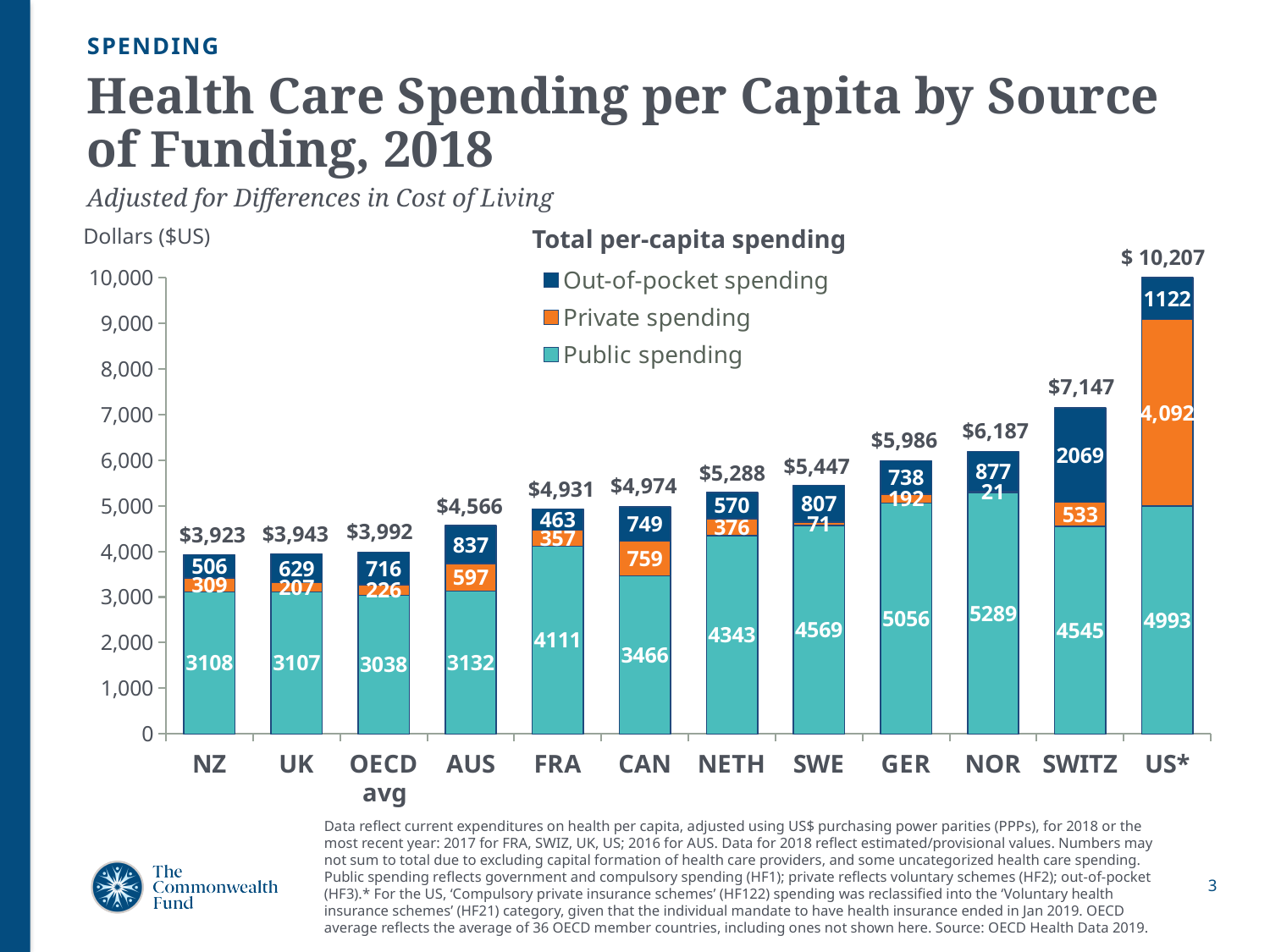
Which country has the highest total per-capita spending? US* Which colour represents public spending in the chart? Teal What is the private spending value for Canada (CAN)? 759 How many countries or groups are shown on the x axis? 12 What is the difference between the total per-capita spending of the US* and Switzerland (SWITZ)? $3,060 What kind of chart is shown on the slide? Stacked bar chart What is the public spending value for Norway (NOR)? 5289 Which has a larger private spending value, the US* or Canada (CAN)? US* How many spending categories does the legend list? 3 What is the total per-capita health care spending for the US* shown above its bar? $ 10,207 Which country has the lowest total per-capita spending? NZ What is the out-of-pocket spending value for Switzerland (SWITZ)? 2069